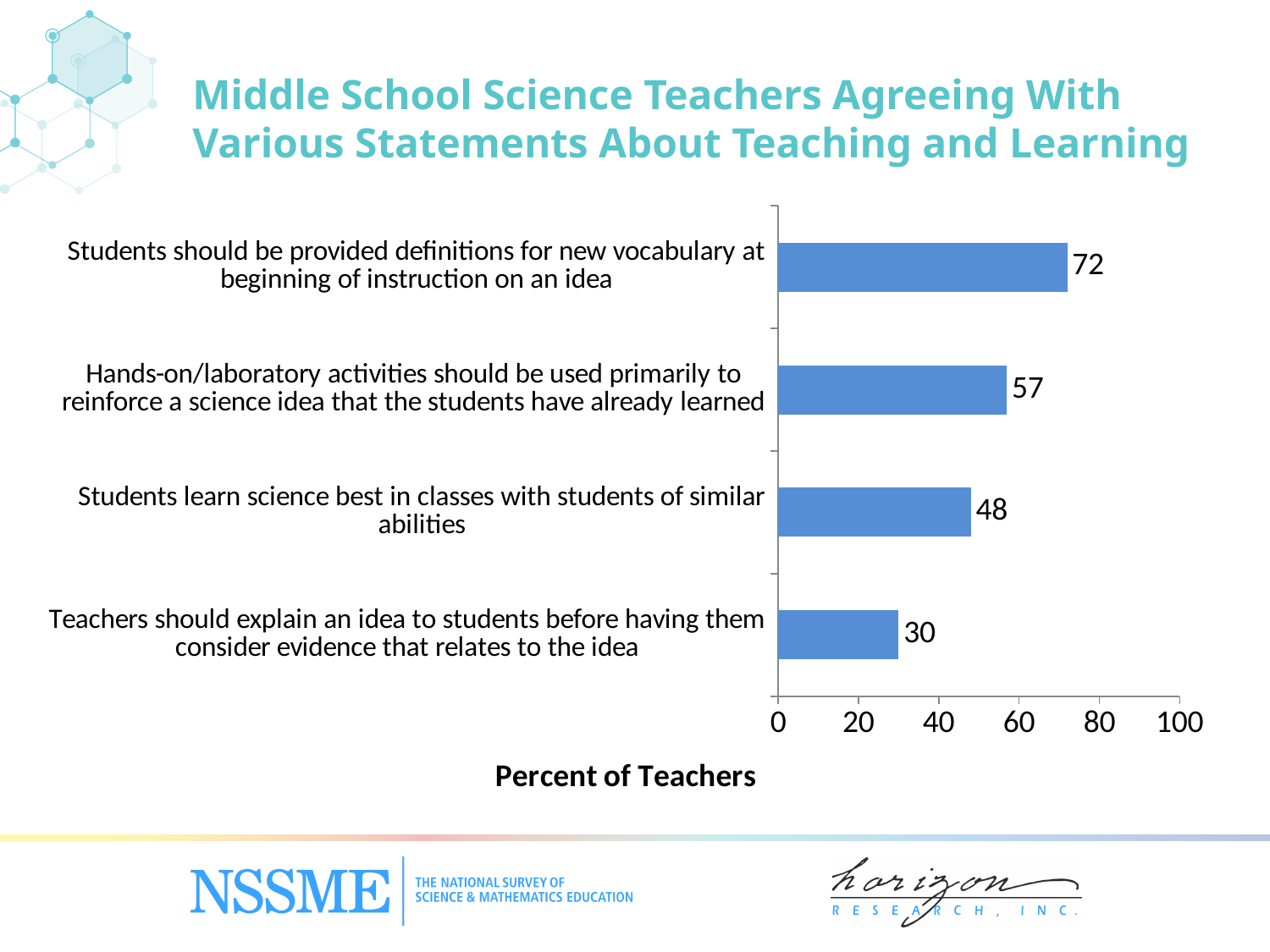
What percent of middle school science teachers agree that students should be provided definitions for new vocabulary at the beginning of instruction on an idea? 72 Which statement has the highest percent of teachers agreeing? Students should be provided definitions for new vocabulary at beginning of instruction on an idea Which has a higher percent of teachers agreeing: the hands-on/laboratory activities statement or the similar abilities statement? Hands-on/laboratory activities should be used primarily to reinforce a science idea that the students have already learned How many statements are shown in the chart? 4 What is the difference in percent of teachers agreeing between the hands-on/laboratory activities statement and the similar abilities statement? 9 Is the percent of teachers agreeing with the similar abilities statement greater or less than 60? less Which statement has the lowest percent of teachers agreeing? Teachers should explain an idea to students before having them consider evidence that relates to the idea What is the difference in percent of teachers agreeing between the vocabulary definitions statement and the explaining an idea before evidence statement? 42 What percent of teachers agree that teachers should explain an idea to students before having them consider evidence that relates to the idea? 30 What percent of teachers agree that hands-on/laboratory activities should be used primarily to reinforce a science idea that students have already learned? 57 What percent of teachers agree that students learn science best in classes with students of similar abilities? 48 What type of chart is shown on the slide? Bar chart